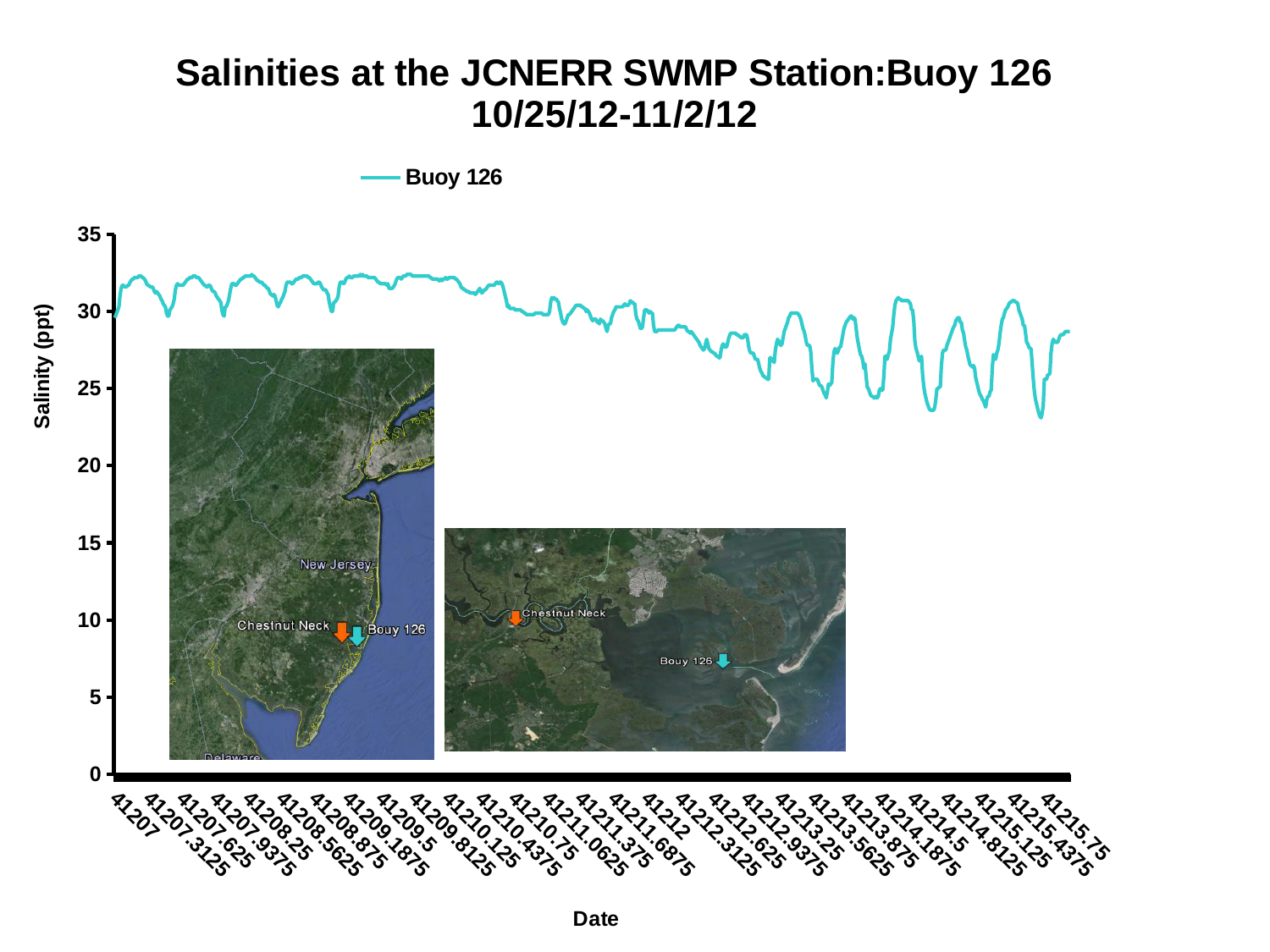
Which is larger, the value at 41208.5625 or the value at 41214.1875? 41208.5625 Does the salinity line ever drop below 25 ppt? yes Does the salinity line ever exceed 35 ppt? no Is the value for 41209.5 greater or less than 30? greater Overall, do the salinity values rise or fall from left to right along the x axis? fall What is the name of the series shown in the legend? Buoy 126 What is the label on the y axis? Salinity (ppt) What kind of chart is shown on the slide? line chart How many series does the legend list? 1